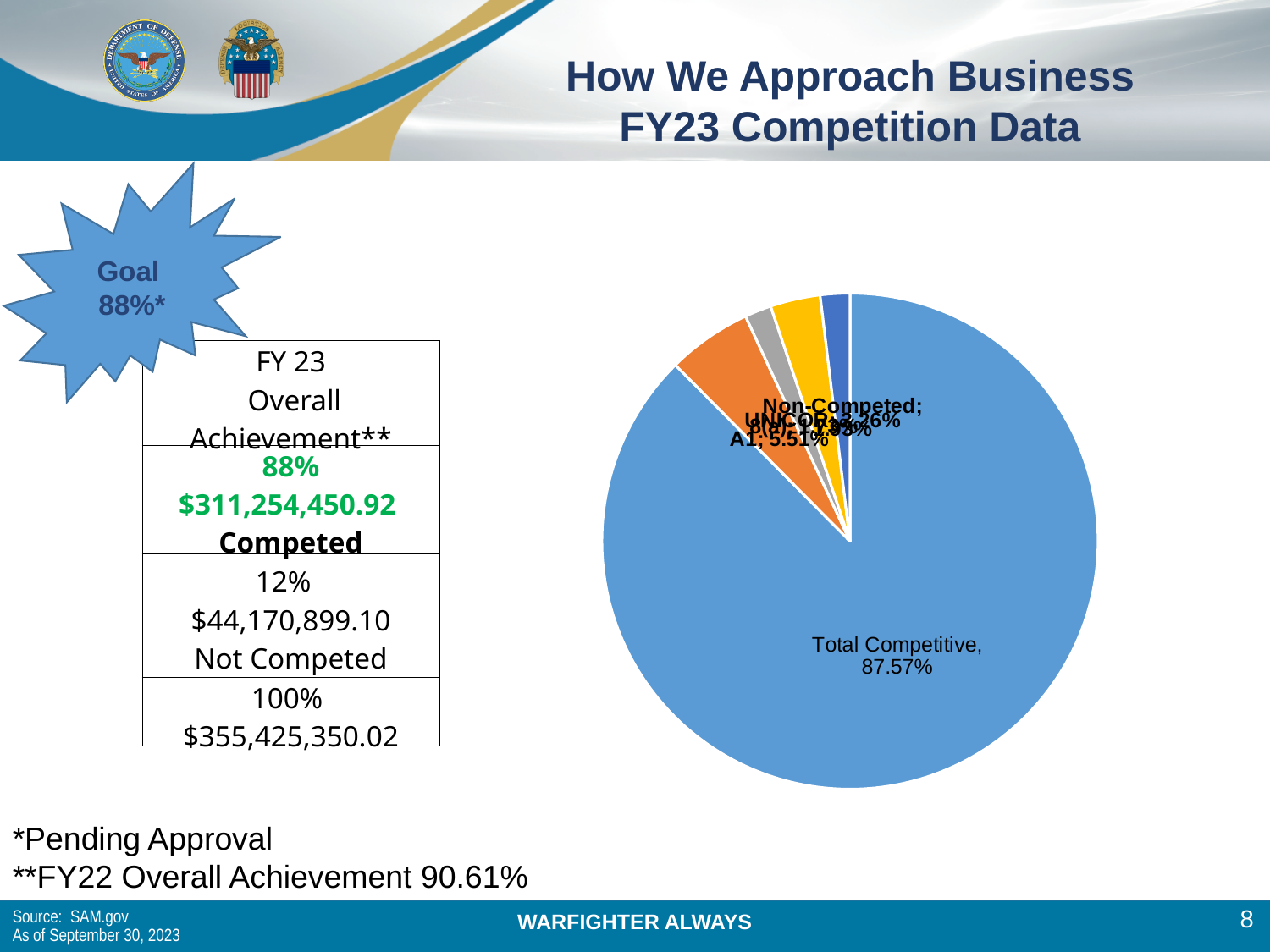
What colour is the Total Competitive slice of the pie chart? blue How many slices does the pie chart have? 5 What kind of chart is shown on the slide? pie chart Which slice of the pie chart is the largest? Total Competitive Which is larger in the pie chart, Total Competitive or Non-Competed? Total Competitive Is the Total Competitive slice more or less than half of the pie? more What share of the pie does Total Competitive represent? 87.57%